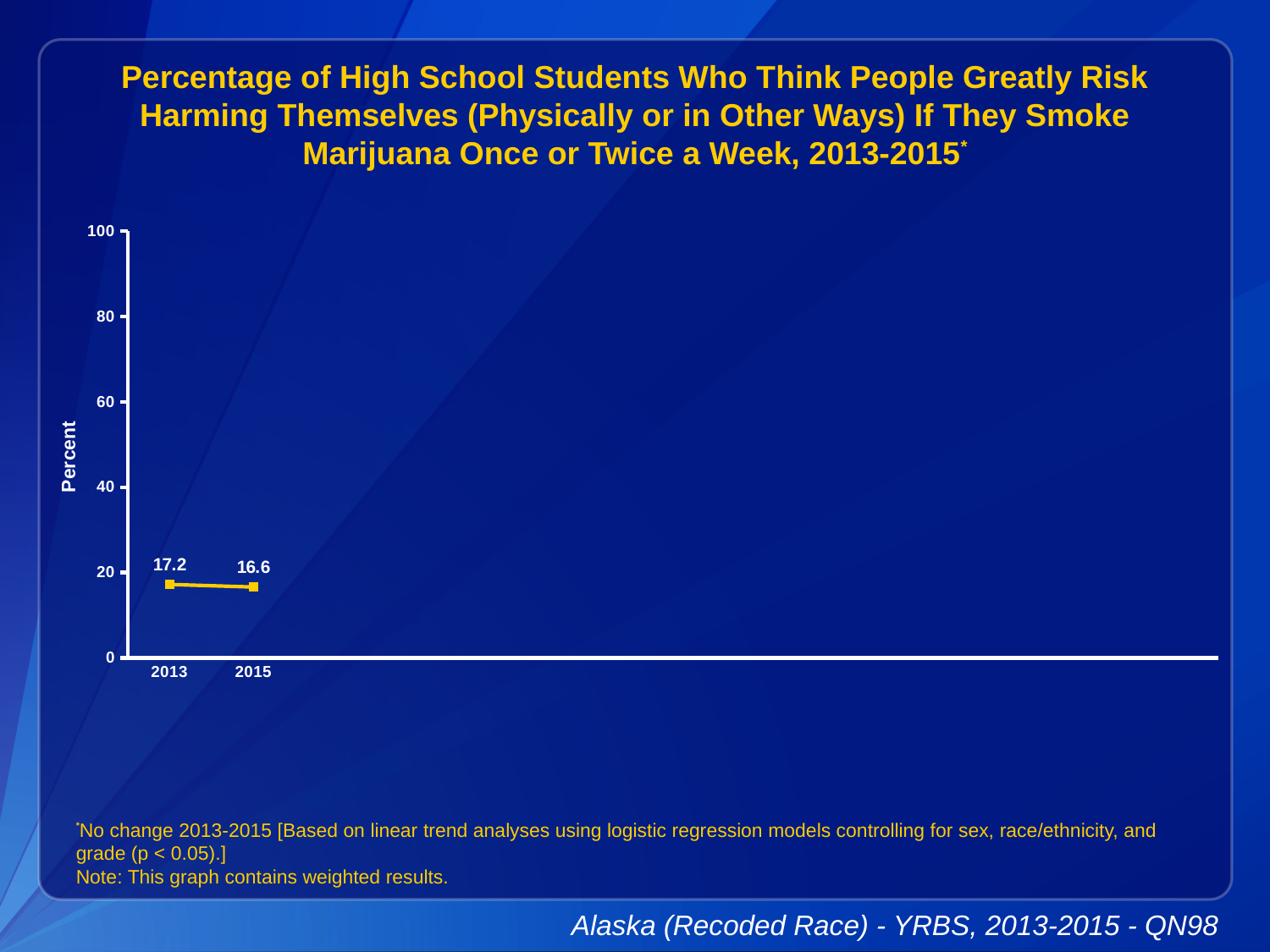
What is the value for 2013? 17.2 Do the values rise or fall from 2013 to 2015? fall Is the value for 2015 greater or less than 40? less What is the label on the y axis? Percent What kind of chart is shown on the slide? line chart What is the maximum value shown on the y axis? 100 How many data points are plotted on the chart? 2 Is the value for 2013 greater or less than 20? less What is the difference between the 2013 and 2015 values? 0.6 Which year has the lowest value? 2015 Which year has the higher value, 2013 or 2015? 2013 What is the value for 2015? 16.6